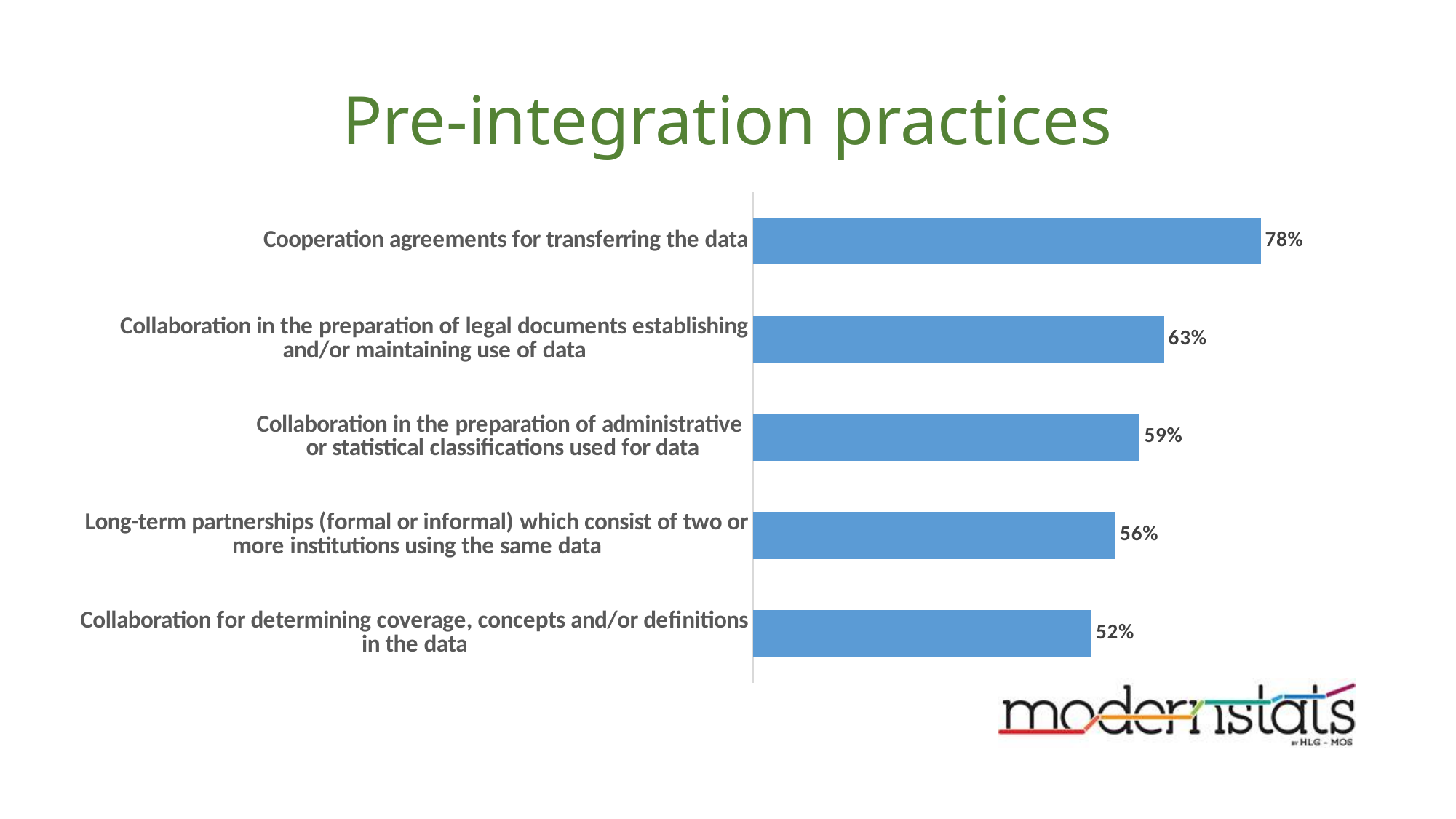
How many categories are shown in the chart? 5 What is the value for 'Long-term partnerships (formal or informal) which consist of two or more institutions using the same data'? 56% What kind of chart is shown on the slide? Bar chart What is the difference between the values for 'Cooperation agreements for transferring the data' and 'Collaboration for determining coverage, concepts and/or definitions in the data'? 26% What is the value for 'Cooperation agreements for transferring the data'? 78% What is the value for 'Collaboration in the preparation of legal documents establishing and/or maintaining use of data'? 63% Which category has the highest value? Cooperation agreements for transferring the data What is the value for 'Collaboration in the preparation of administrative or statistical classifications used for data'? 59% What is the difference between the values for 'Collaboration in the preparation of legal documents establishing and/or maintaining use of data' and 'Collaboration in the preparation of administrative or statistical classifications used for data'? 4% Which category has the lowest value? Collaboration for determining coverage, concepts and/or definitions in the data What is the value for 'Collaboration for determining coverage, concepts and/or definitions in the data'? 52% Which is larger: the value for 'Long-term partnerships (formal or informal) which consist of two or more institutions using the same data' or the value for 'Collaboration for determining coverage, concepts and/or definitions in the data'? Long-term partnerships (formal or informal) which consist of two or more institutions using the same data